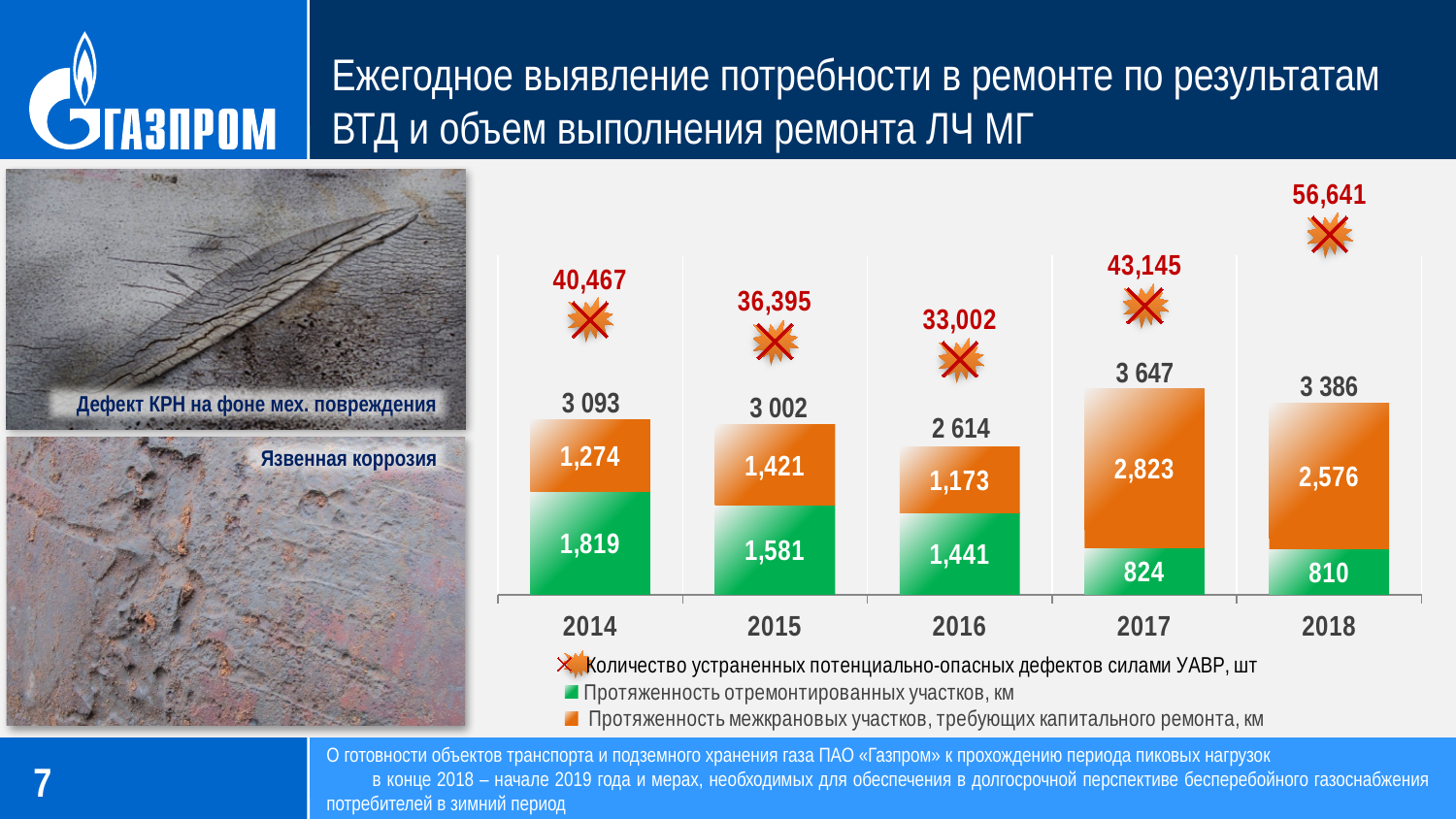
How many series does the legend list? 3 In which year is the green series (Протяженность отремонтированных участков, км) the lowest? 2018 How many years are shown on the x axis of the chart? 5 What is the value of the green series (Протяженность отремонтированных участков, км) for 2014? 1,819 Which is larger in 2015: the green series value or the orange series value? Green series (1,581) In which year is the number of eliminated potentially dangerous defects (star markers) the highest? 2018 What is the value of the orange series (Протяженность межкрановых участков, требующих капитального ремонта, км) for 2017? 2,823 What is the number of eliminated potentially dangerous defects (Количество устраненных потенциально-опасных дефектов силами УАВР, шт) for 2018? 56,641 What is the total shown above the stacked bar for 2016? 2 614 What is the difference between the orange series values for 2017 and 2018? 247 What kind of chart is shown on the slide? Stacked bar chart Does the green series (Протяженность отремонтированных участков, км) rise or fall from 2014 to 2018? Fall